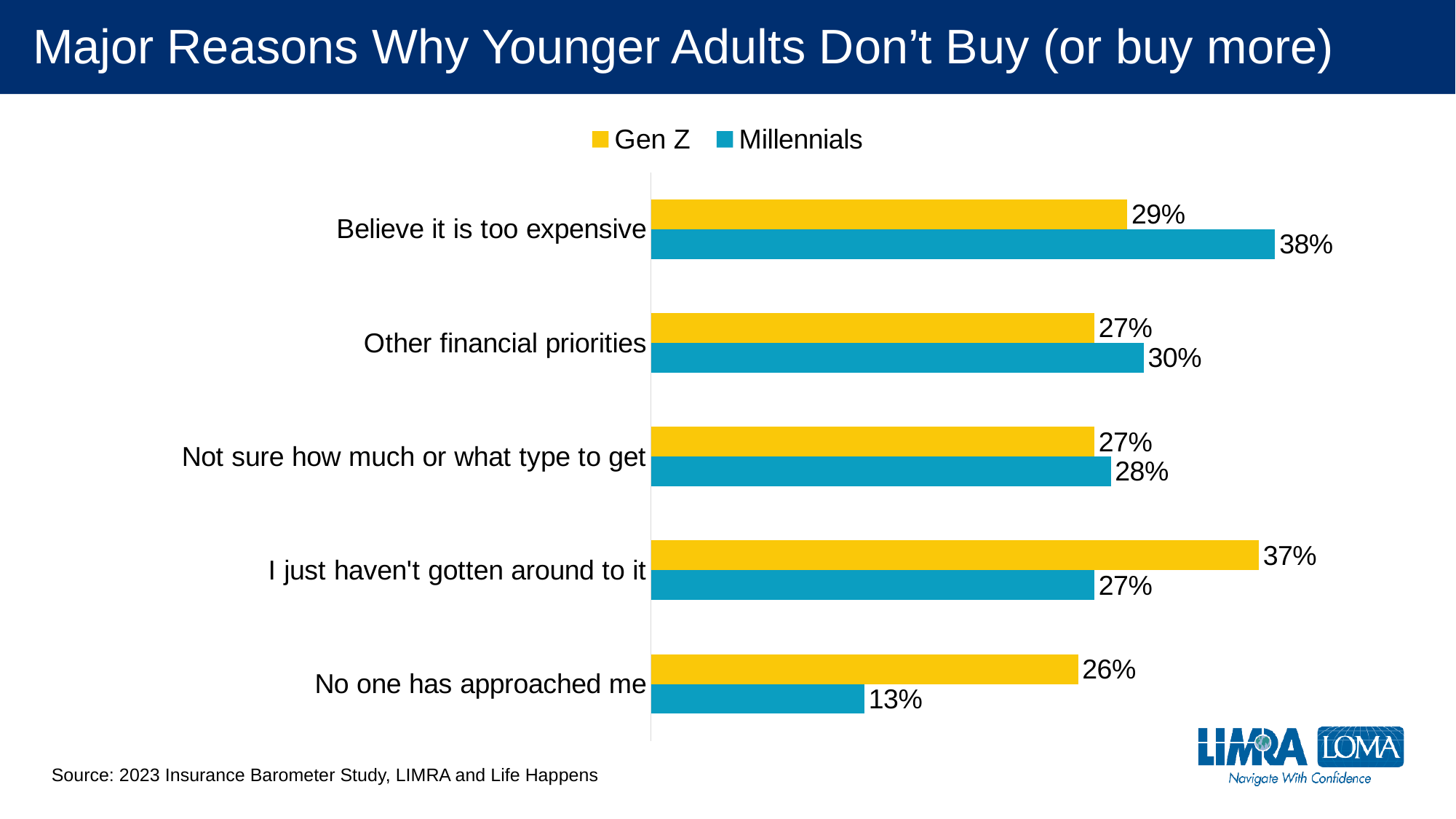
What is the difference between the Gen Z and Millennials values for 'No one has approached me'? 13% What percentage of Millennials say no one has approached them? 13% Which reason has the lowest value for Millennials? No one has approached me What percentage of Gen Z say they believe it is too expensive? 29% What is the difference between the Millennials and Gen Z values for 'Believe it is too expensive'? 9% What type of chart is shown on the slide? Bar chart Which reason has the highest value for Gen Z? I just haven't gotten around to it How many reasons (categories) are shown in the chart? 5 Which reason has the highest value for Millennials? Believe it is too expensive How many series does the legend list? 2 For 'I just haven't gotten around to it', which group has the larger value, Gen Z or Millennials? Gen Z What percentage of Gen Z say they just haven't gotten around to it? 37%